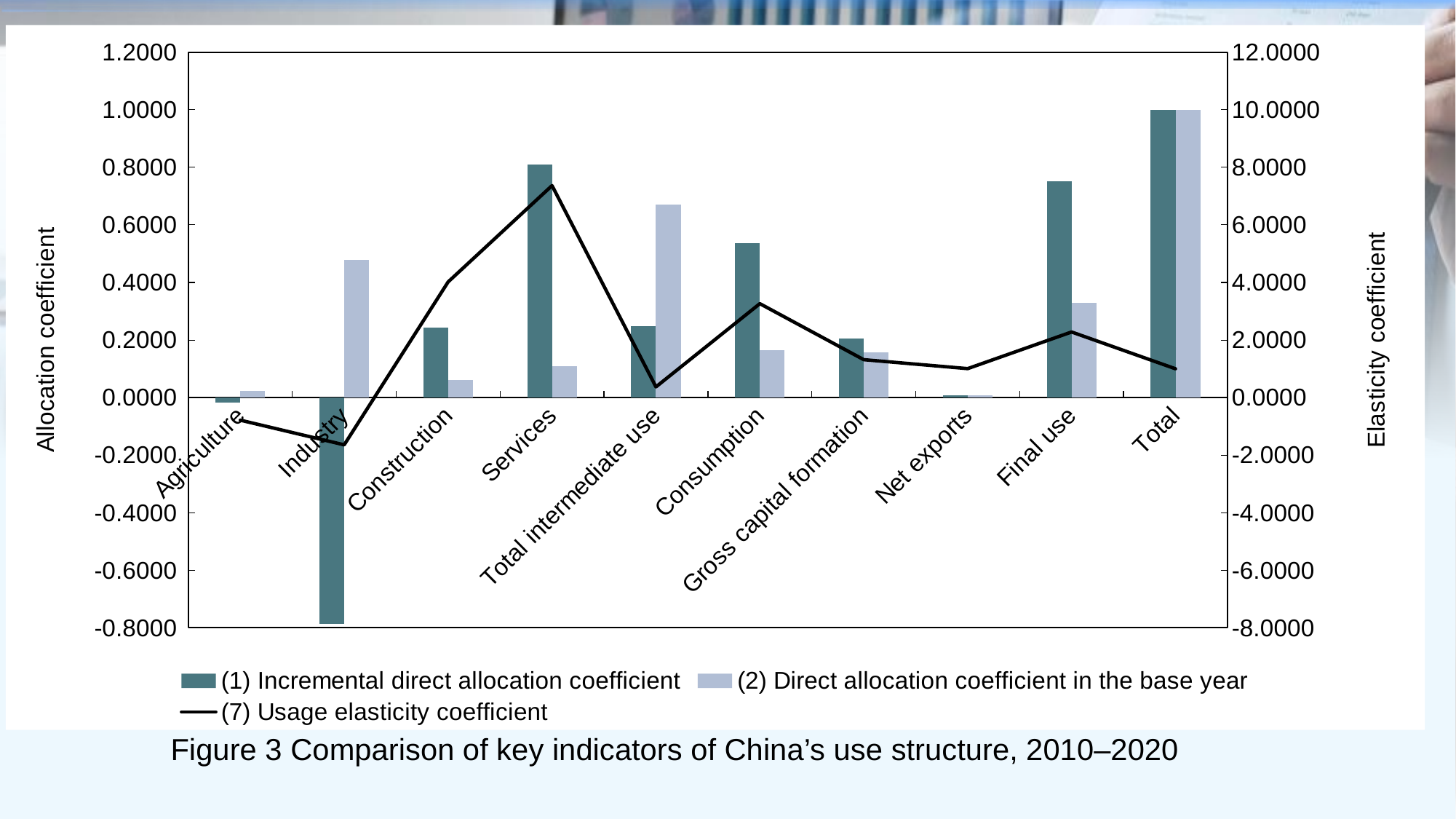
Is the (1) Incremental direct allocation coefficient for Industry greater or less than -0.6000? less For Industry, which is larger: the (1) Incremental direct allocation coefficient or the (2) Direct allocation coefficient in the base year? (2) Direct allocation coefficient in the base year Which category has the highest value for the (2) Direct allocation coefficient in the base year? Total Is the (7) Usage elasticity coefficient for Services greater or less than 6.0000? greater What kind of chart is shown on the slide? A combined bar and line chart Which category has the highest value for the (1) Incremental direct allocation coefficient? Total Is the (2) Direct allocation coefficient in the base year for Total intermediate use greater or less than 0.6000? greater How many series does the legend list? 3 What is the label of the right-hand vertical axis? Elasticity coefficient Which category has the lowest value for the (1) Incremental direct allocation coefficient? Industry How many categories are shown along the x axis? 10